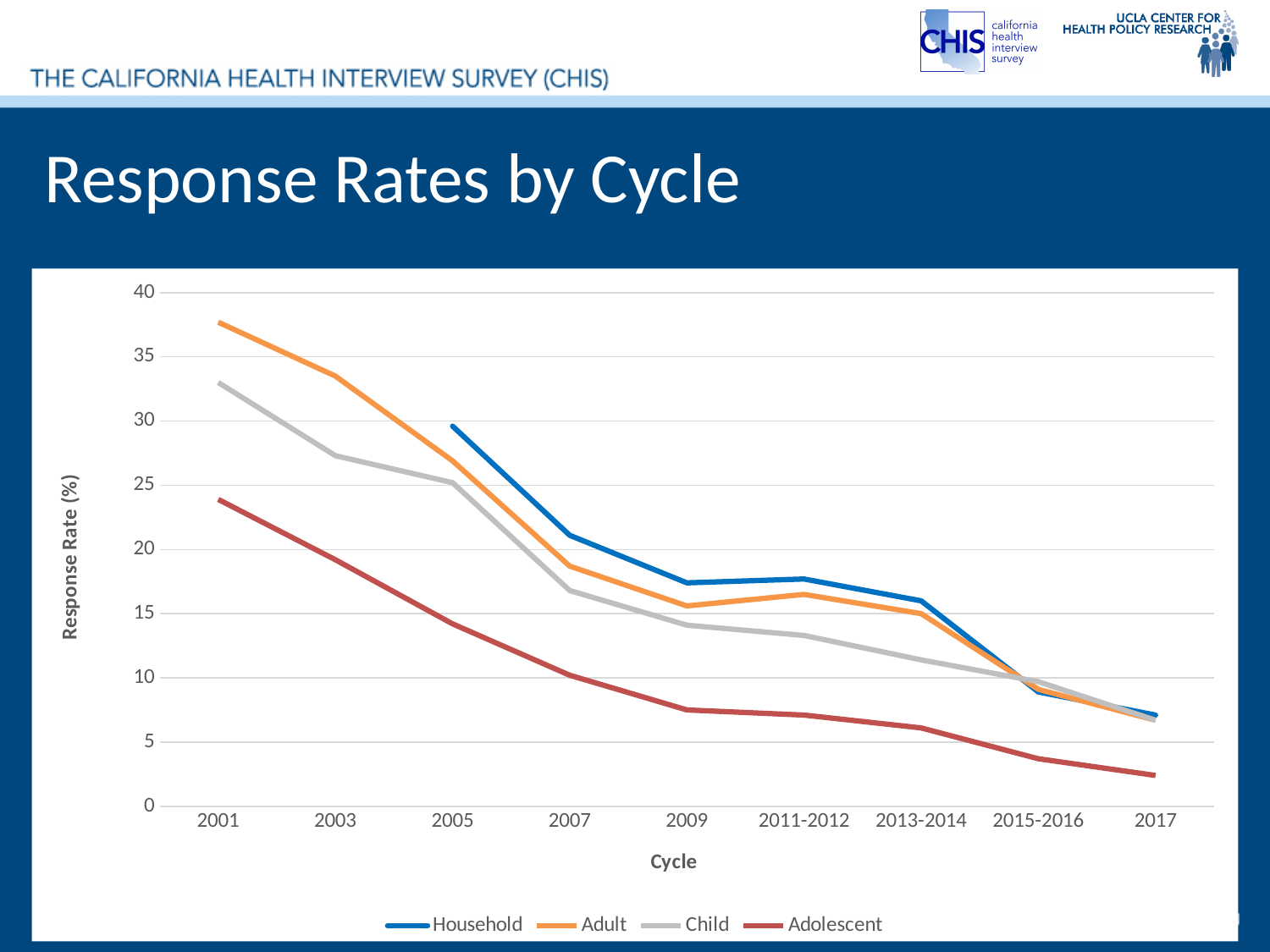
Is the Adolescent response rate in 2017 greater or less than 5? less How many series does the legend list? 4 What kind of chart is shown on the slide? Line chart Do the response rates generally rise or fall from 2001 to 2017? Fall Is the Adult response rate in 2001 greater or less than 35? greater What is the title of the y axis? Response Rate (%) In 2003, which is larger, the Adult response rate or the Child response rate? Adult Which series has the lowest response rate in 2001? Adolescent Which series has the highest response rate in 2001? Adult Is the Child response rate in 2011-2012 greater or less than 15? less How many cycles are shown along the x axis? 9